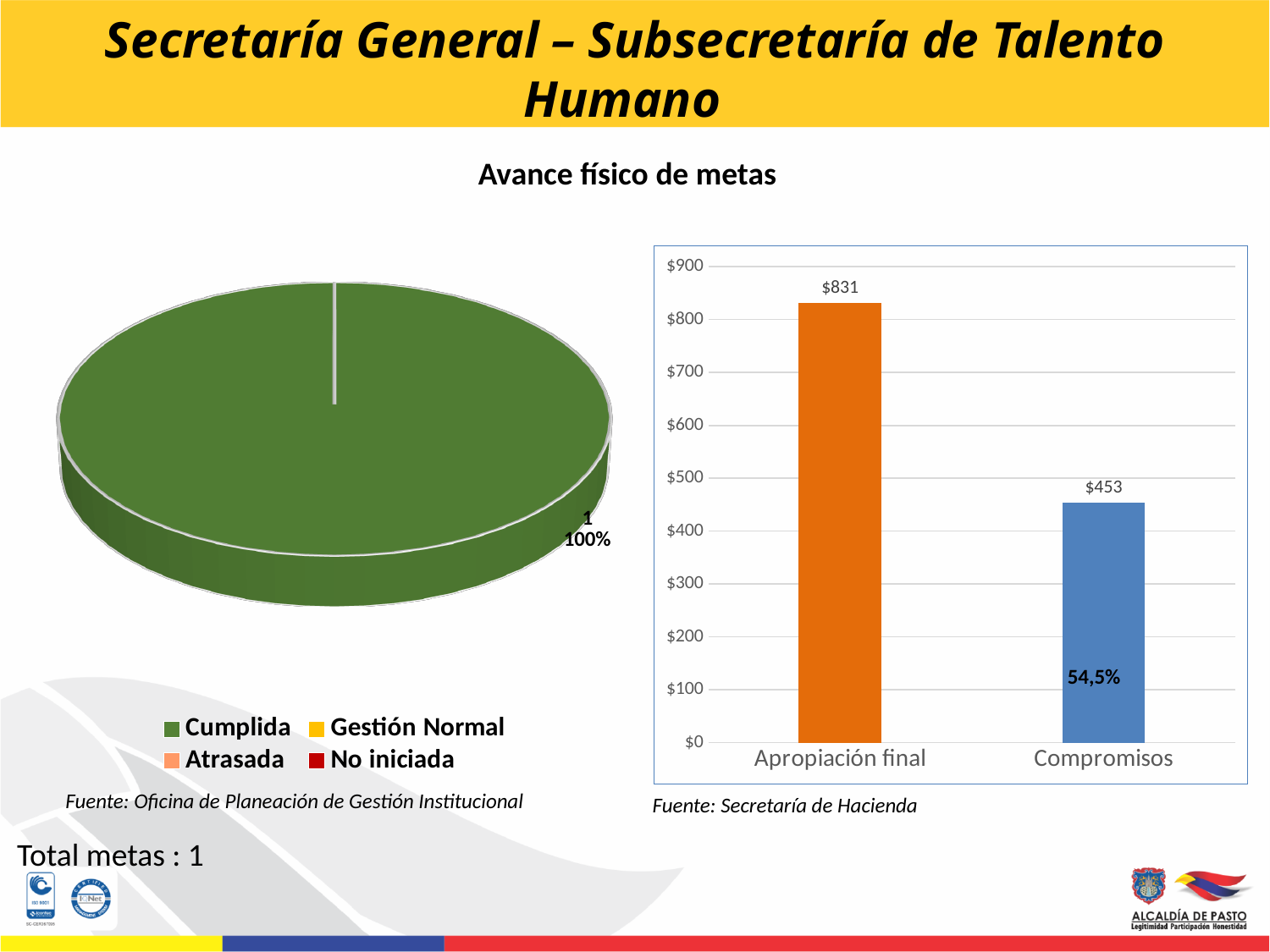
In the bar chart on the right, which category has the lowest value? Compromisos In the bar chart on the right, what percentage label is printed on the Compromisos bar? 54,5% In the bar chart on the right, what is the difference between Apropiación final and Compromisos? $378 In the bar chart on the right, which category has the highest value? Apropiación final What is the title shown above the pie chart on the left? Avance físico de metas In the bar chart on the right, what is the value for Compromisos? $453 What kind of chart is the chart on the right? bar chart In the bar chart on the right, how many categories are shown on the x axis? 2 In the bar chart on the right, what is the value for Apropiación final? $831 How many entries does the legend of the pie chart on the left list? 4 In the pie chart on the left, what share does the Cumplida slice represent? 100% In the bar chart on the right, is the value for Compromisos greater or less than $500? less